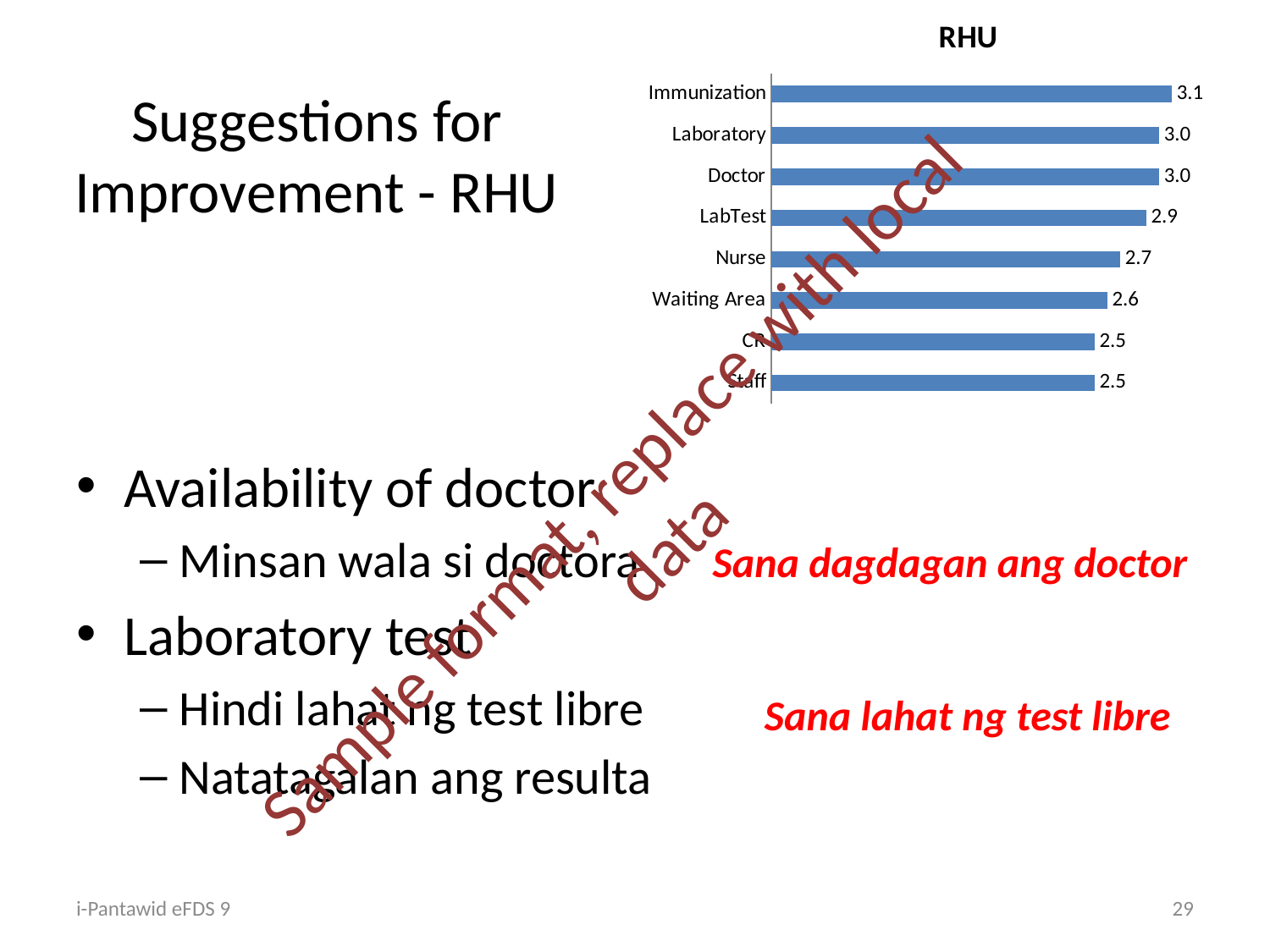
What is the value for Waiting Area in the RHU chart? 2.6 How many bars are shown in the RHU chart? 8 What is the value for LabTest in the RHU chart? 2.9 Which category has the highest value in the RHU chart? Immunization What is the title of the chart on the slide? RHU What is the value for Immunization in the RHU chart? 3.1 What is the difference between the values for Laboratory and Waiting Area in the RHU chart? 0.4 What is the value for Nurse in the RHU chart? 2.7 What is the difference between the values for Immunization and Nurse in the RHU chart? 0.4 What kind of chart is shown on the slide? Bar chart Which is larger in the RHU chart, the value for LabTest or the value for Nurse? LabTest What is the value for Doctor in the RHU chart? 3.0